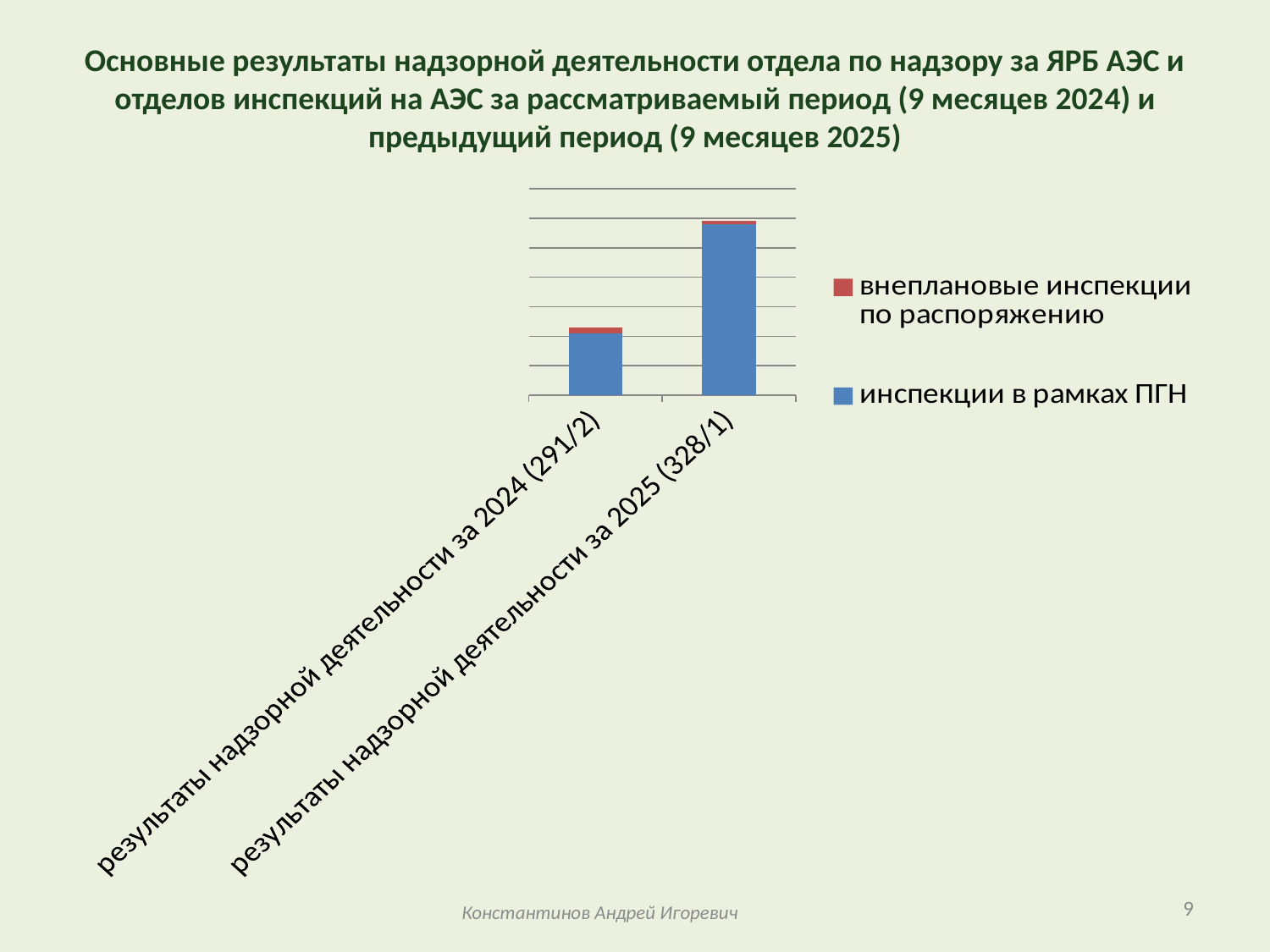
Do the bar heights rise or fall from the 2024 category to the 2025 category? rise How many series does the chart legend list? 2 Which category has the shorter stacked bar? результаты надзорной деятельности за 2024 (291/2) Which series is shown in blue in the chart legend? инспекции в рамках ПГН How many categories are plotted on the x axis of the chart? 2 Which series is shown in red in the chart legend? внеплановые инспекции по распоряжению What kind of chart is shown on the slide? bar chart Which category has the taller stacked bar: результаты надзорной деятельности за 2024 (291/2) or результаты надзорной деятельности за 2025 (328/1)? результаты надзорной деятельности за 2025 (328/1) Is the stacked bar for 2025 (328/1) larger or smaller than the stacked bar for 2024 (291/2)? larger Within the 2024 (291/2) bar, which series takes up the larger portion: инспекции в рамках ПГН or внеплановые инспекции по распоряжению? инспекции в рамках ПГН